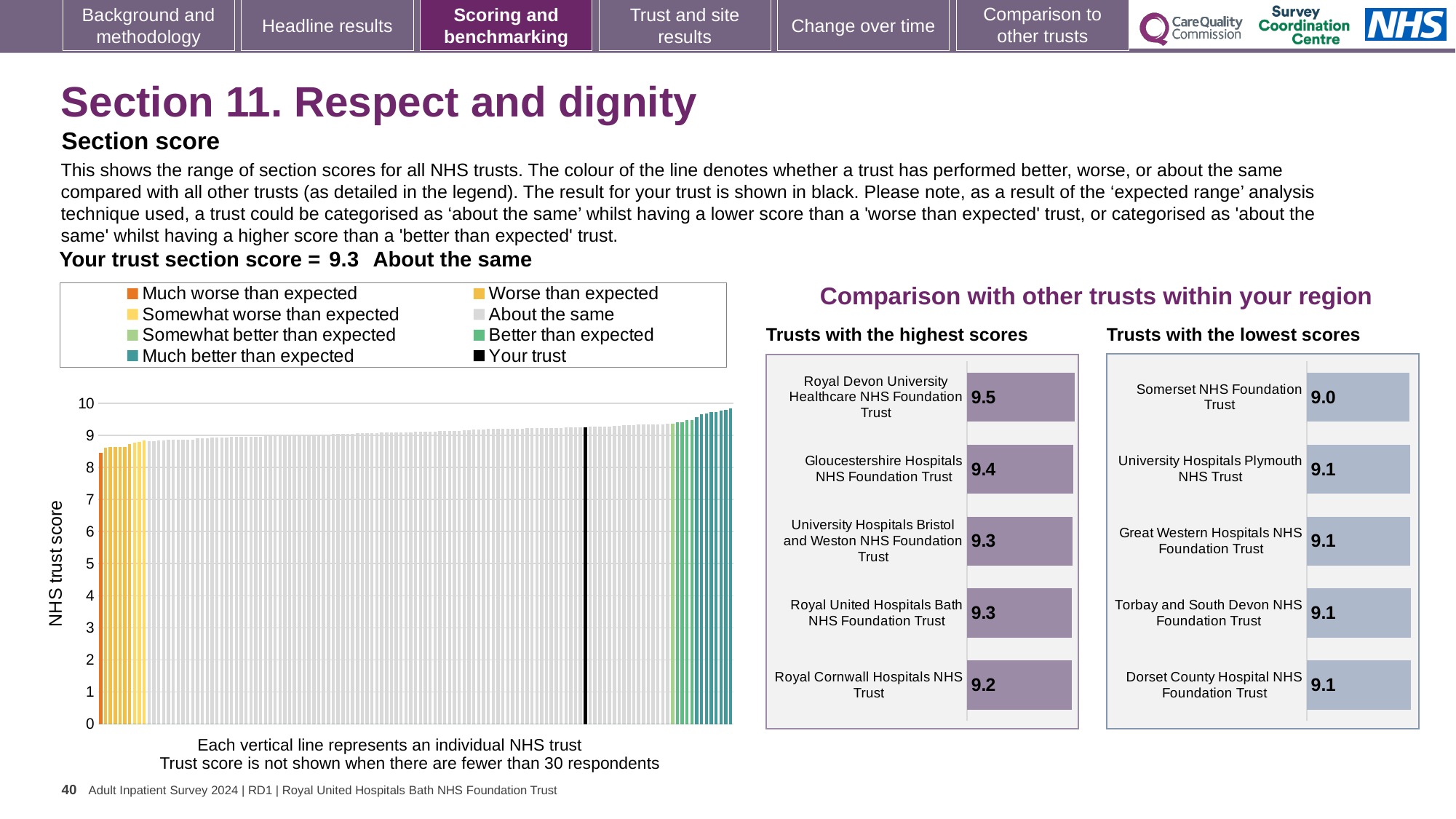
How many entries does the legend above the large chart on the left list? 8 In the 'Trusts with the lowest scores' chart, which trust has the lowest score? Somerset NHS Foundation Trust What kind of chart is the large chart on the left showing NHS trust scores? bar chart In the large chart on the left, what is the label on the vertical axis? NHS trust score In the large chart on the left, do the trust scores rise or fall from left to right? rise In the 'Trusts with the highest scores' chart, which has the larger score: Gloucestershire Hospitals NHS Foundation Trust or Royal Cornwall Hospitals NHS Trust? Gloucestershire Hospitals NHS Foundation Trust In the 'Trusts with the highest scores' chart, what is the score for Royal Devon University Healthcare NHS Foundation Trust? 9.5 In the 'Trusts with the highest scores' chart, which trust has the highest score? Royal Devon University Healthcare NHS Foundation Trust In the large chart on the left, is the value of the black bar (your trust) greater or less than 9? greater In the 'Trusts with the highest scores' chart, how many trusts are listed? 5 In the 'Trusts with the lowest scores' chart, what is the score for Somerset NHS Foundation Trust? 9.0 In the 'Trusts with the highest scores' chart, what is the difference between the scores of Royal Devon University Healthcare NHS Foundation Trust and Royal Cornwall Hospitals NHS Trust? 0.3